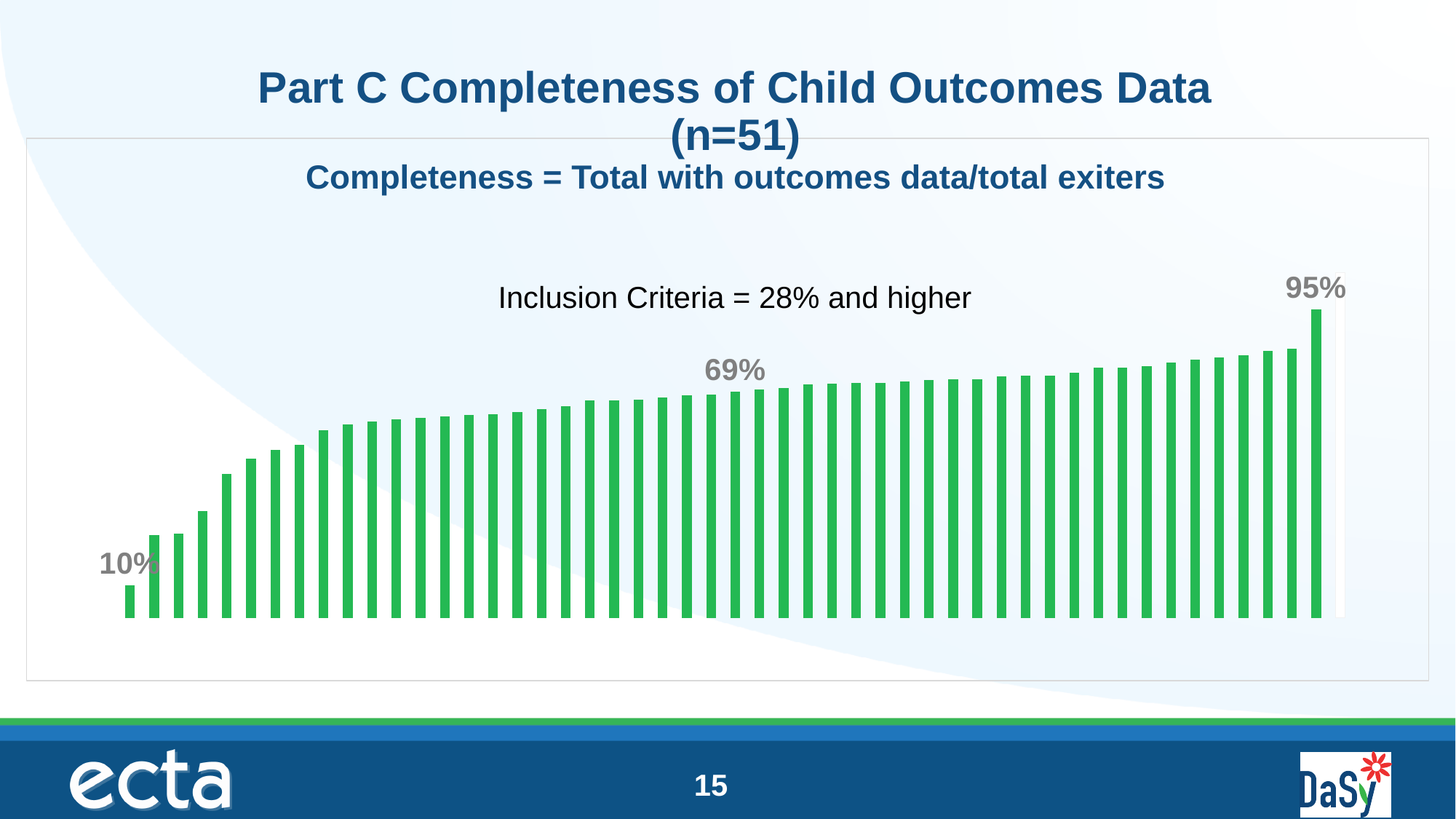
What is the title of the chart on the slide? Part C Completeness of Child Outcomes Data (n=51) What is the value labeled on the tallest (rightmost) bar in the chart? 95% How many bars (states/entities) are plotted in the chart, according to the n given in the title? 51 What is the difference between the middle bar's label (69%) and the leftmost bar's label (10%)? 59 percentage points Which is larger, the value of the leftmost bar or the value of the rightmost bar? The rightmost bar (95%) Do the bar values rise or fall from left to right across the chart? Rise What is the difference between the highest labeled value (95%) and the lowest labeled value (10%)? 85 percentage points What value is labeled on the bar in the middle of the chart? 69% What is the value labeled on the shortest (leftmost) bar in the chart? 10% What kind of chart is shown on the slide? Bar chart What is the difference between the rightmost bar's label (95%) and the middle bar's label (69%)? 26 percentage points What inclusion criteria is stated on the chart? 28% and higher